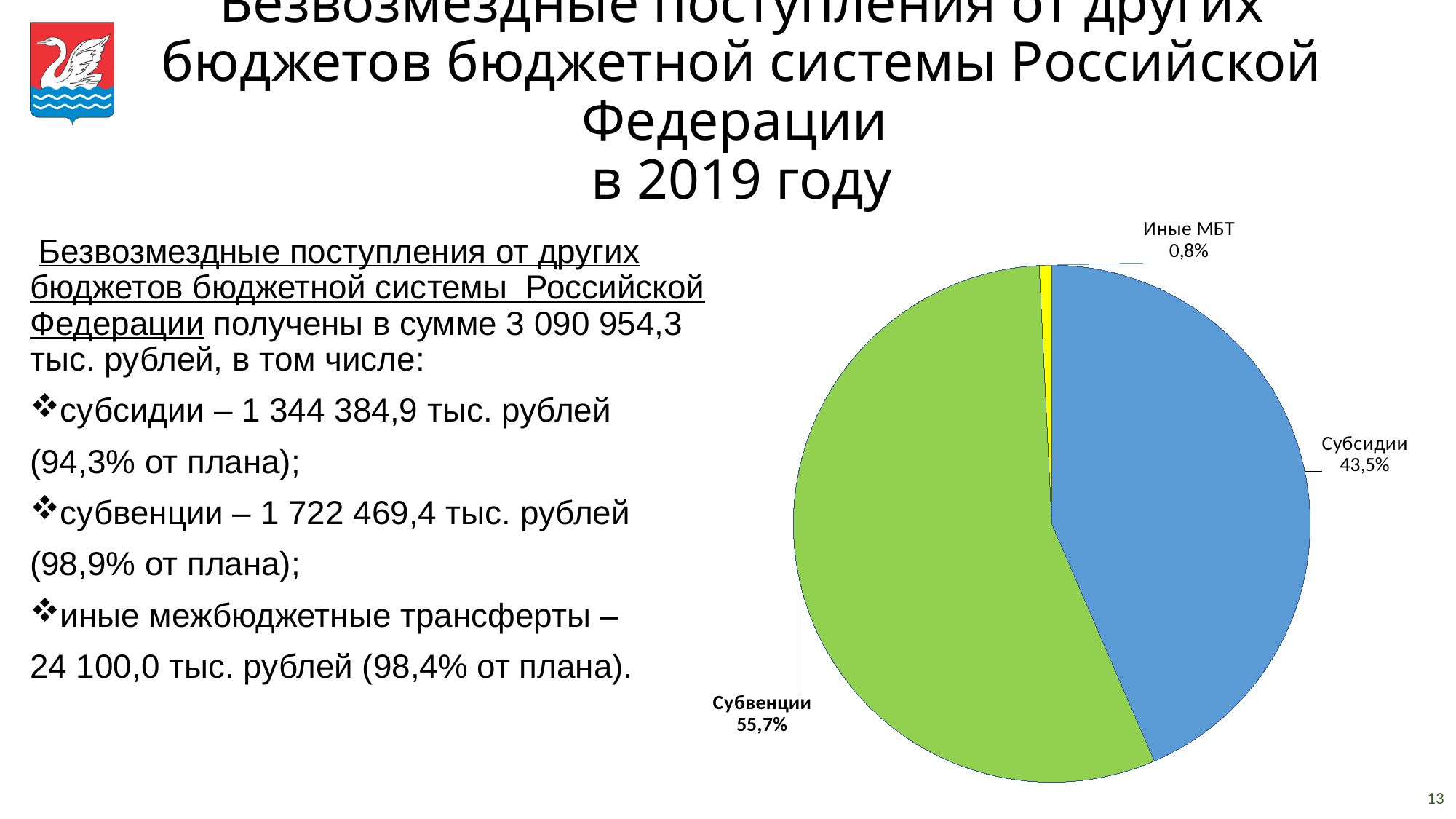
How many slices does the pie chart have? 3 Which slice of the pie chart is the largest? Субвенции Which is larger in the pie chart, Субсидии or Субвенции? Субвенции What share of the pie does Субсидии have? 43,5% What kind of chart is shown on the slide? pie chart What is the difference in percentage points between the Субвенции and Субсидии slices? 12,2 Which slice of the pie chart is the smallest? Иные МБТ What colour is the Субсидии slice in the pie chart? blue What share of the pie does Иные МБТ have? 0,8% What colour is the Субвенции slice in the pie chart? green What is the difference in percentage points between the Субсидии and Иные МБТ slices? 42,7 What share of the pie does Субвенции have? 55,7%